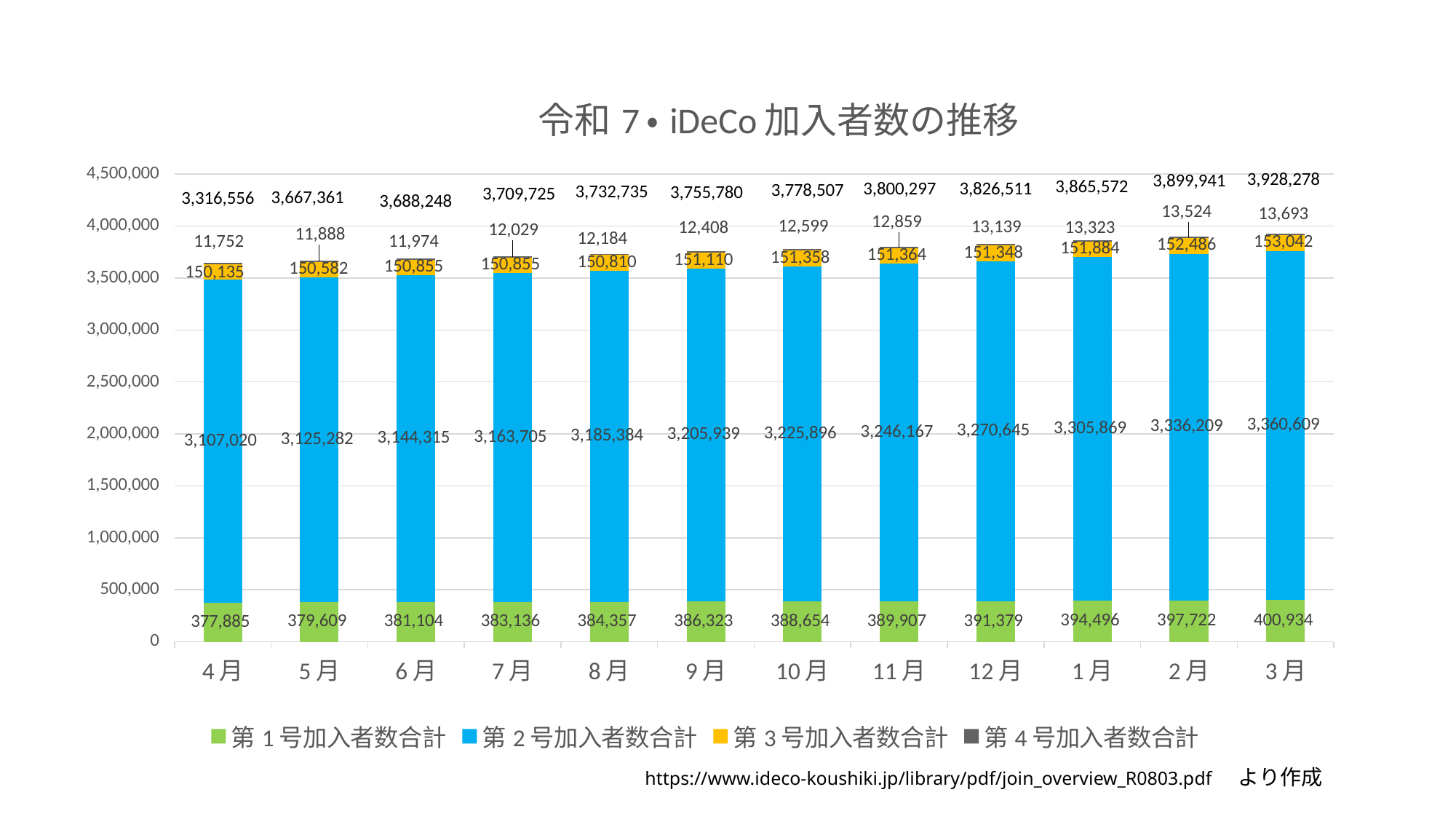
How many series does the legend list? 4 What kind of chart is shown on the slide? Stacked bar chart Which month has the highest value for 第2号加入者数合計? 3月 What is the value of 第2号加入者数合計 for 3月? 3,360,609 Does the value of 第2号加入者数合計 rise or fall from 4月 to 3月? Rise What is the value of 第1号加入者数合計 for 9月? 386,323 What is the total of the stacked bar for 5月? 3,667,361 Which month has the lowest value for 第1号加入者数合計? 4月 What is the difference between the 第1号加入者数合計 values for 3月 and 4月? 23,049 What is the value of 第3号加入者数合計 for 1月? 151,884 What is the value of 第4号加入者数合計 for 11月? 12,859 How many months are shown on the x axis? 12